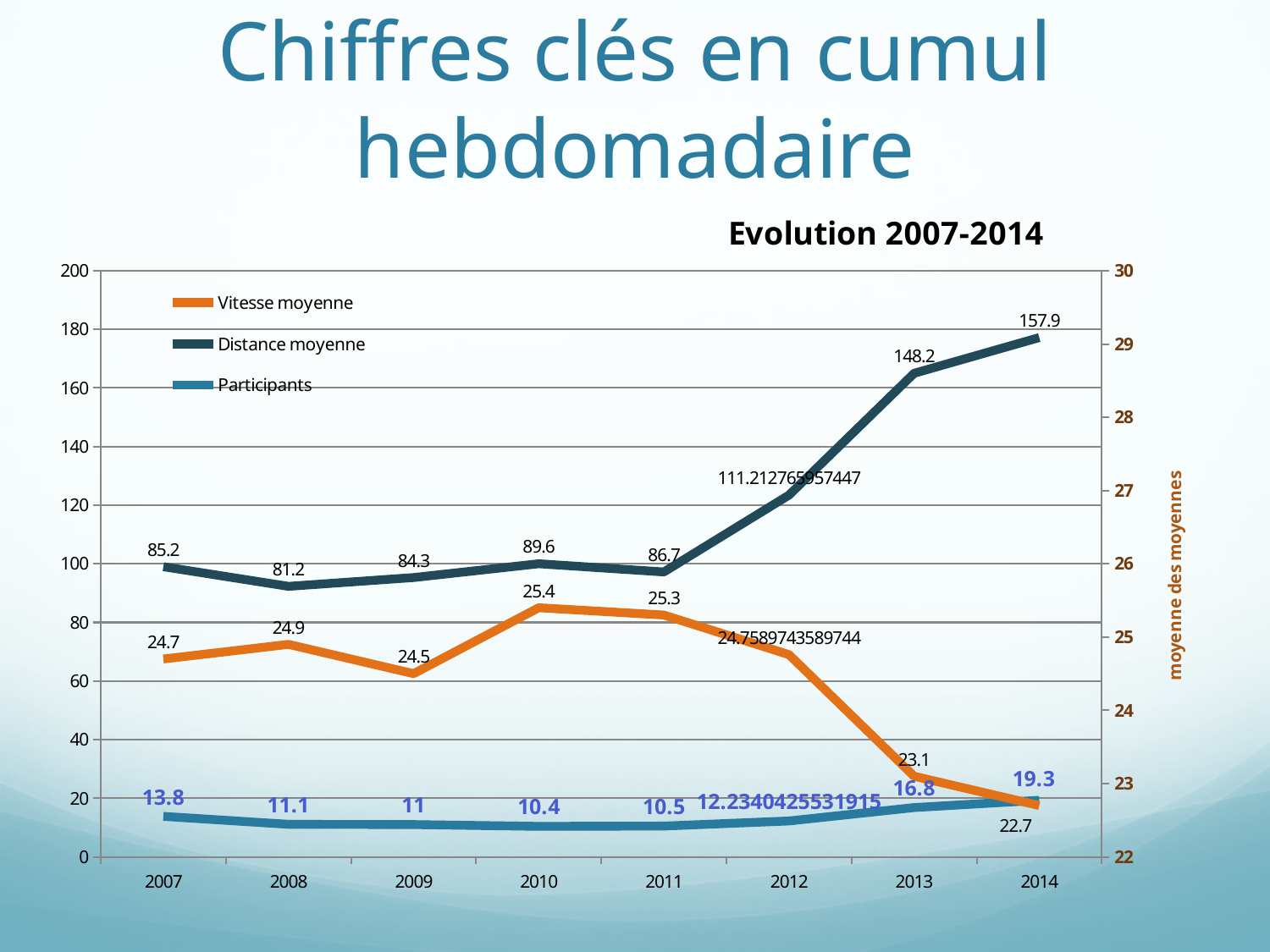
What is the value of Vitesse moyenne in 2010? 25.4 In which year is Distance moyenne at its highest? 2014 How many years are plotted along the x axis? 8 What is the value of Participants in 2007? 13.8 What is the value of Distance moyenne in 2014? 157.9 In which year is Participants at its lowest? 2010 Does Vitesse moyenne rise or fall between 2011 and 2014? fall What type of chart is shown on the slide? line chart What is the title of the chart? Evolution 2007-2014 Which is larger, Vitesse moyenne in 2008 or in 2009? 2008 What is the difference between Distance moyenne in 2014 and in 2013? 9.7 How many series does the legend list? 3